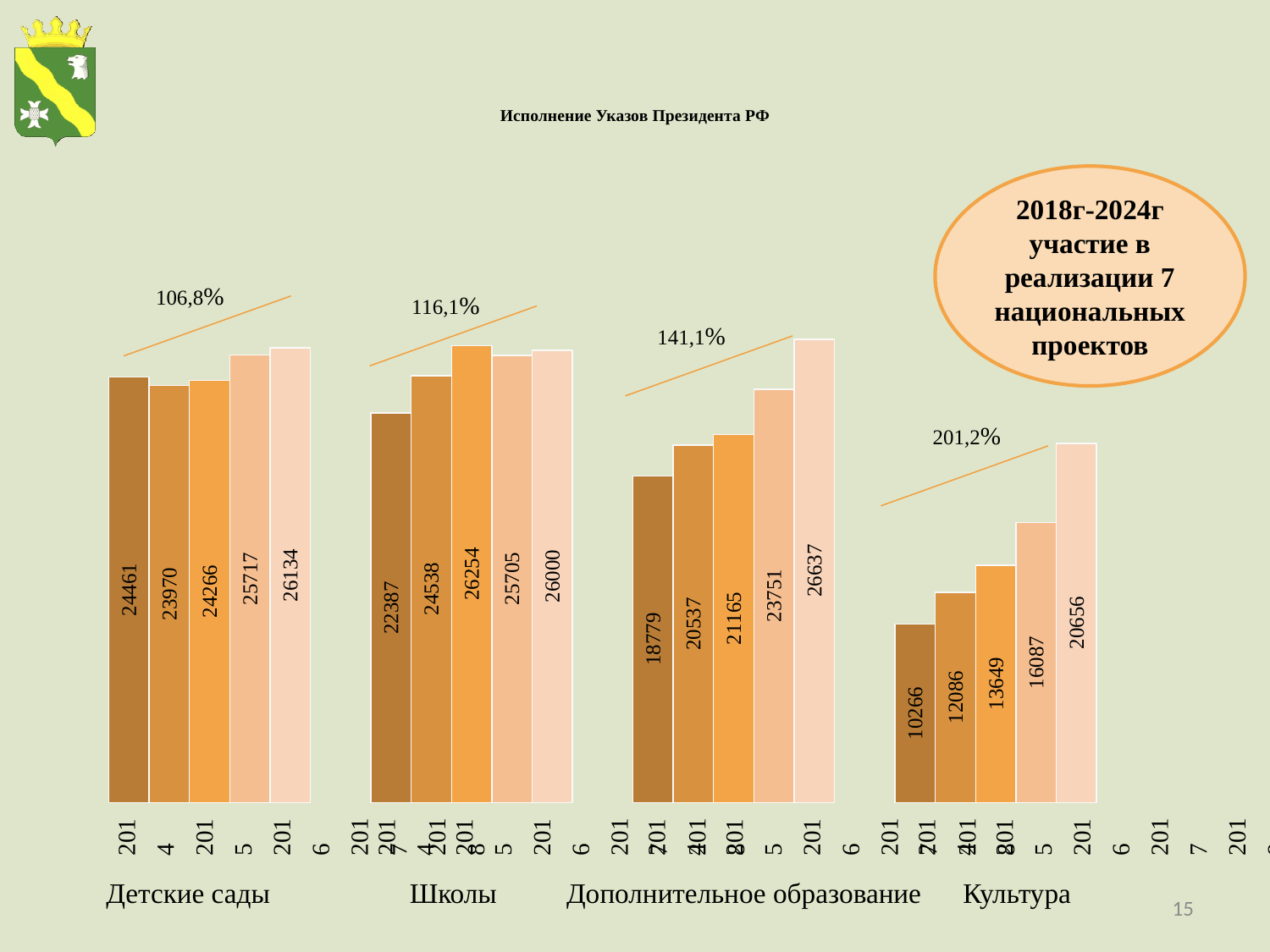
Do the values in the Культура group rise or fall from left to right? rise Which is larger: the last bar in the Дополнительное образование group or the last bar in the Детские сады group? Дополнительное образование (26637) Which bar in the Школы group has the highest value? 26254 How many bars are in each group on the chart? 5 What is the difference between the last and first bars in the Культура group? 10390 What growth percentage is shown above the Культура group? 201,2% In the Культура group, what is the value of the last (rightmost) bar? 20656 In the Детские сады group, what is the value of the last (rightmost) bar? 26134 In the Дополнительное образование group, what is the value of the first (leftmost) bar? 18779 In the Школы group, what is the value of the first (leftmost) bar? 22387 Which bar in the Детские сады group has the lowest value? 23970 What kind of chart is shown on the slide? bar chart